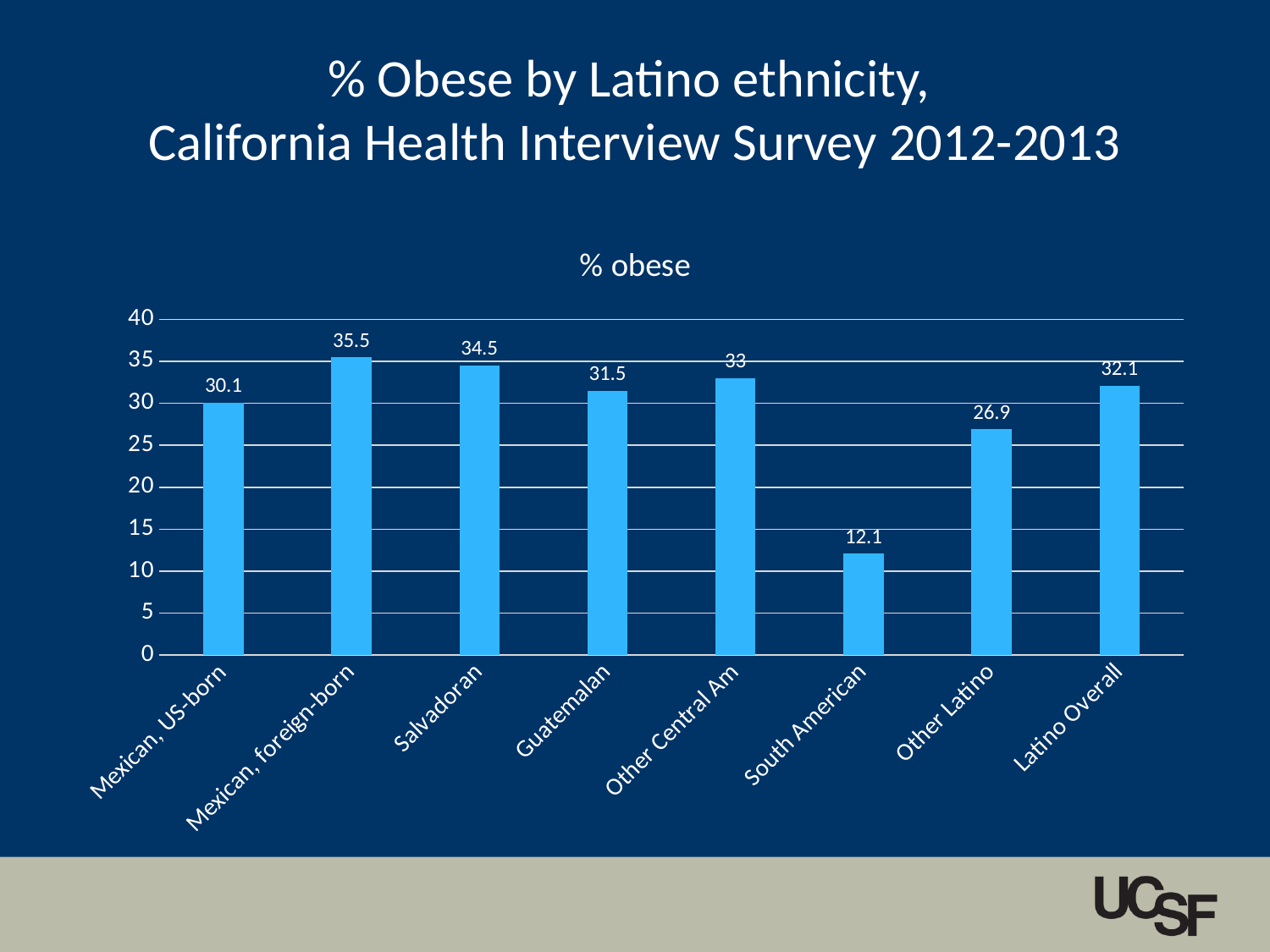
What kind of chart is shown on the slide? bar chart Is the value for Other Latino greater or less than 30? less What is the % obese value for Latino Overall? 32.1 What is the % obese value for Salvadoran? 34.5 Which category has the highest % obese? Mexican, foreign-born What is the difference in % obese between Mexican, foreign-born and Mexican, US-born? 5.4 What is the difference in % obese between Other Central Am and Other Latino? 6.1 What is the % obese value for South American? 12.1 How many categories are shown on the x axis? 8 Which has a higher % obese, Guatemalan or Other Latino? Guatemalan Which category has the lowest % obese? South American What is the title of the chart? % obese